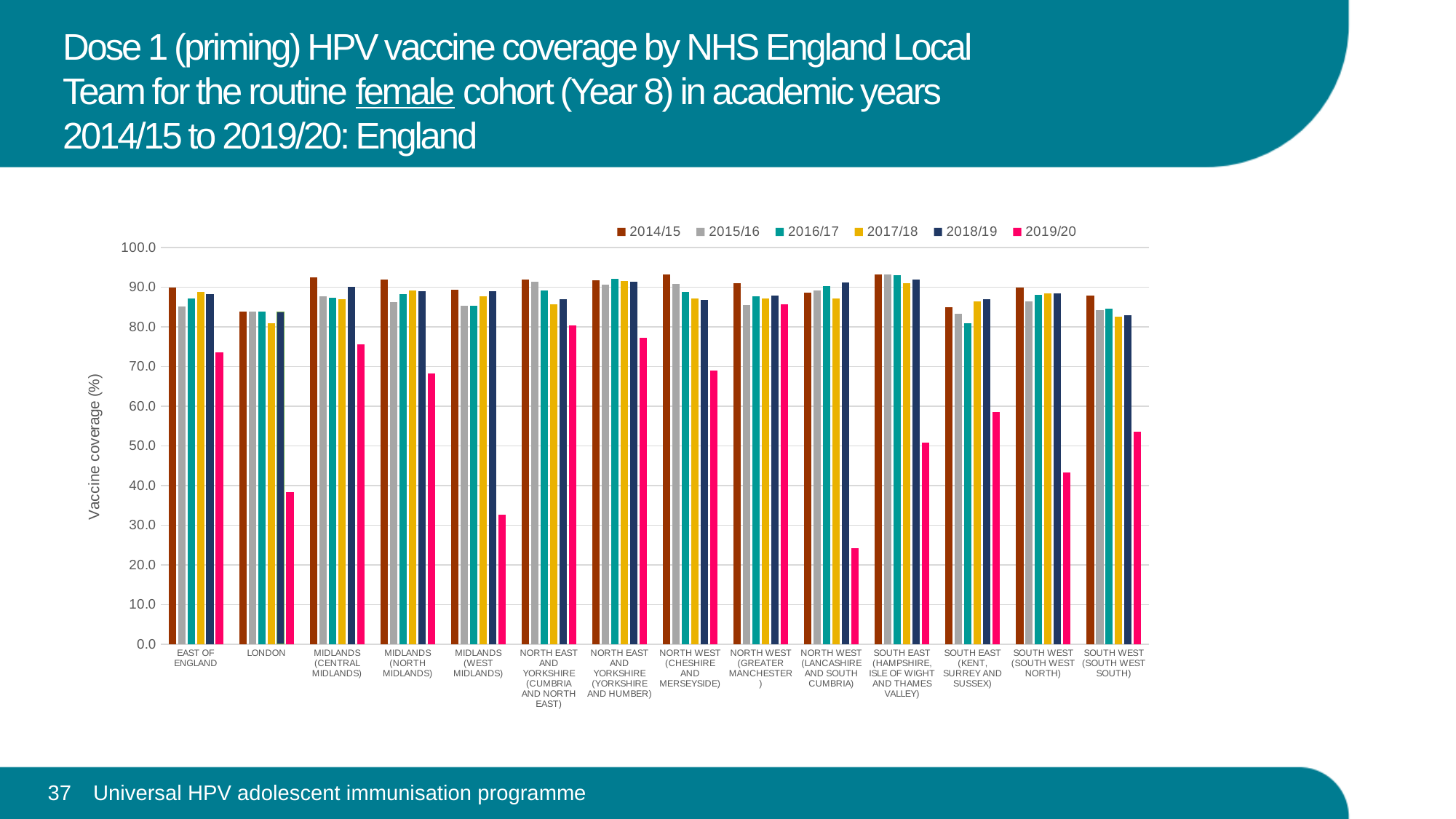
How many NHS England Local Teams are shown on the x axis? 14 Is the 2014/15 value for EAST OF ENGLAND greater or less than 80? greater Is the 2019/20 value for LONDON greater or less than 50? less Which has the larger 2019/20 value, EAST OF ENGLAND or LONDON? EAST OF ENGLAND What kind of chart is shown on the slide? Bar chart What is the label on the y axis? Vaccine coverage (%) How many series does the legend list? 6 For MIDLANDS (WEST MIDLANDS), is the 2019/20 value larger or smaller than the 2018/19 value? smaller Is the 2019/20 value for SOUTH WEST (SOUTH WEST NORTH) greater or less than 50? less Which local team has the lowest 2019/20 value? NORTH WEST (LANCASHIRE AND SOUTH CUMBRIA) Which local team has the highest 2019/20 value? NORTH WEST (GREATER MANCHESTER)